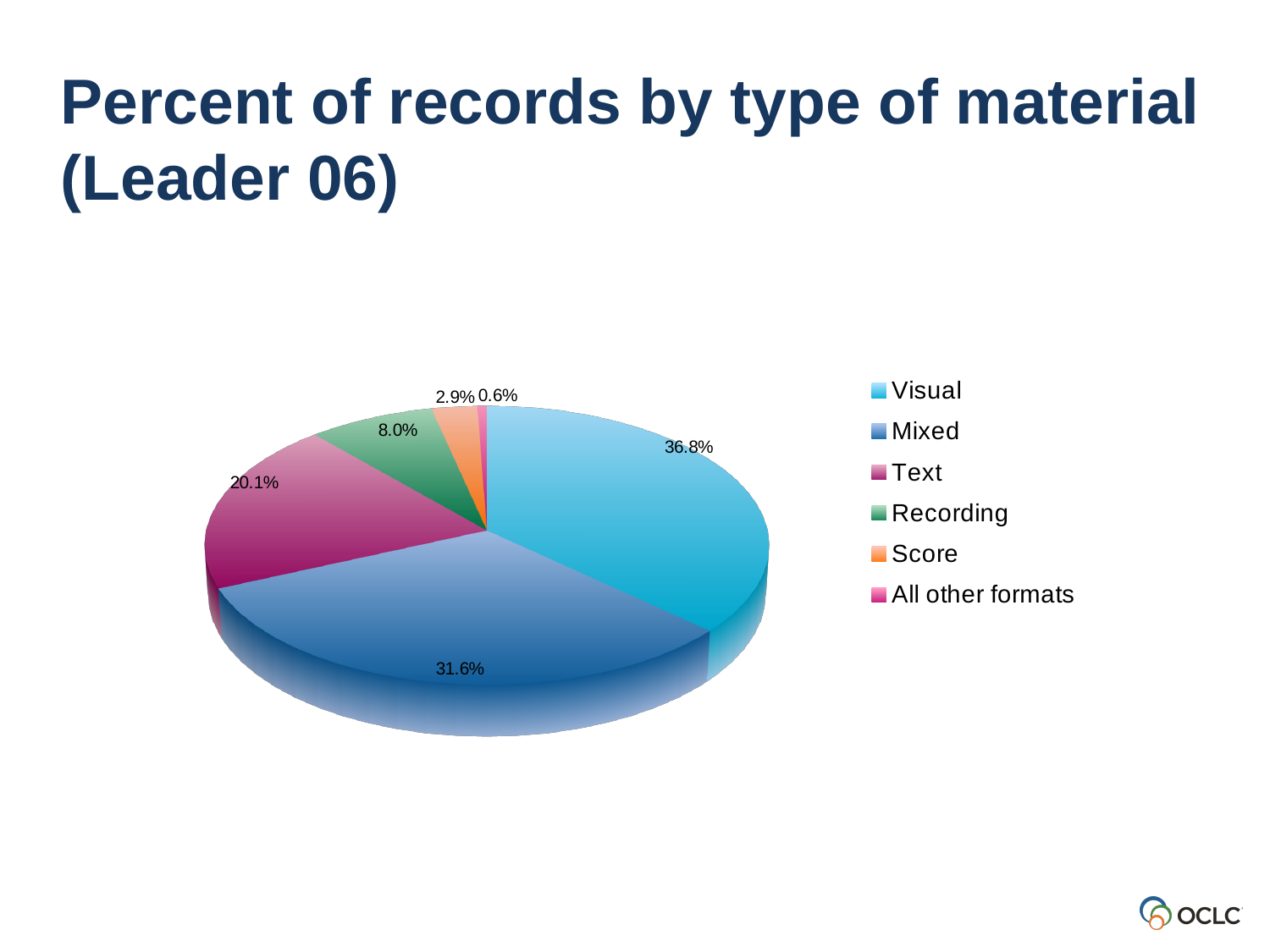
What is the title of the slide containing the chart? Percent of records by type of material (Leader 06) Which has a larger share of records, Text or Recording? Text What is the difference in percentage points between the Visual and Mixed shares? 5.2 Which type of material has the smallest share of records? All other formats What kind of chart is shown on the slide? pie chart What percentage of records are Score materials? 2.9% What percentage of records are Visual materials? 36.8% What percentage of records are Text materials? 20.1% How many types of material does the legend list? 6 Which type of material has the largest share of records? Visual What percentage of records are Mixed materials? 31.6% What percentage of records are Recording materials? 8.0%